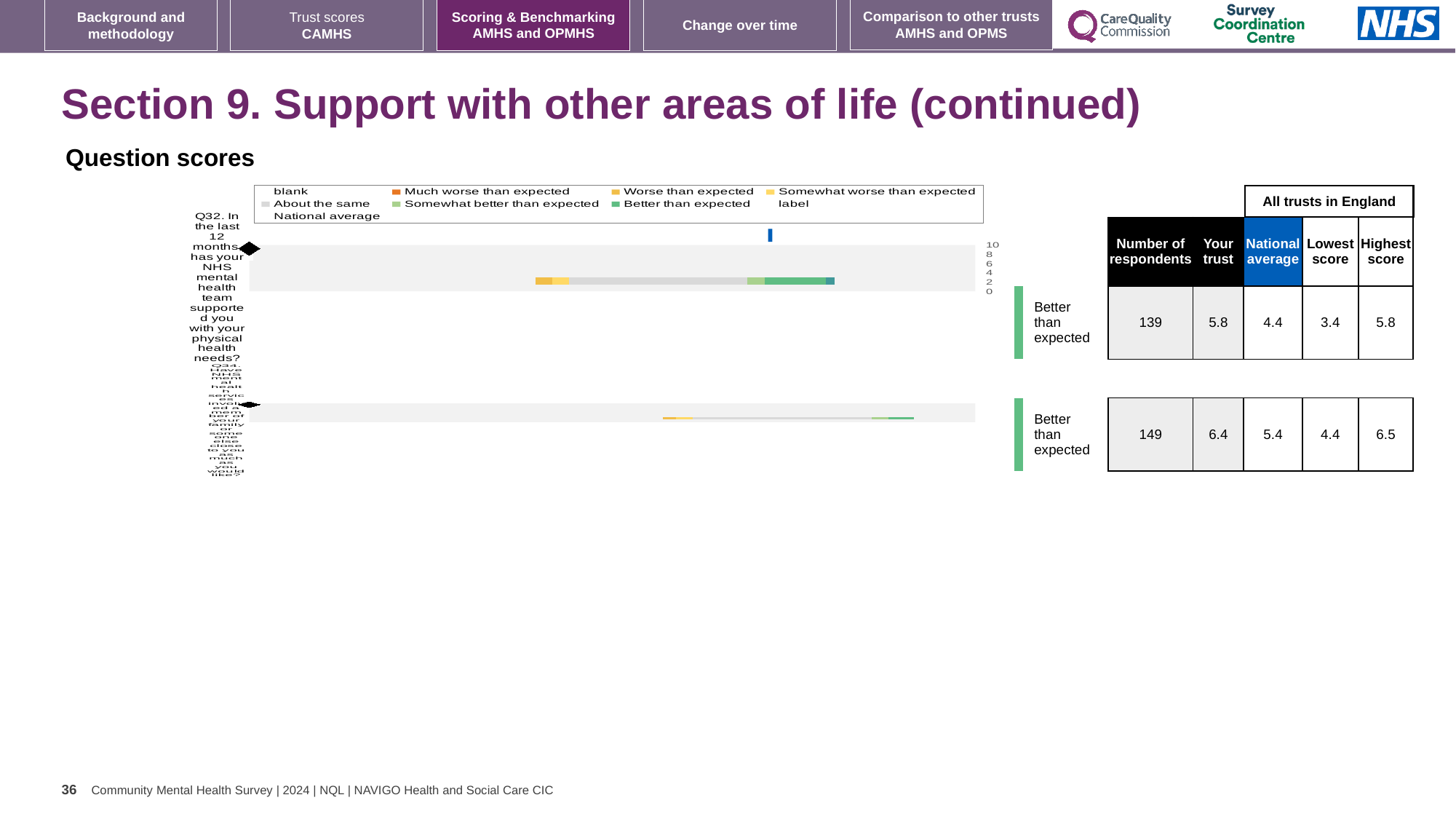
What colour does the legend use for 'Better than expected'? Green By how much does the 'Your trust' score for Q34 exceed the national average for Q34? 1.0 What is the number of respondents for Q34 in the table beside the chart? 149 What is the difference between the highest score and the lowest score for Q32? 2.4 Which question has more respondents, Q32 or Q34? Q34 What is the national average for Q32 in the table beside the chart? 4.4 What rating label is shown next to the Q32 bar? Better than expected What kind of chart is shown under 'Question scores'? Bar chart What is the highest score for Q34 in the table beside the chart? 6.5 Which question is plotted as the top bar of the chart? Q32 How many question bars are plotted in the chart? 2 What is the 'Your trust' score for Q32 in the table beside the chart? 5.8